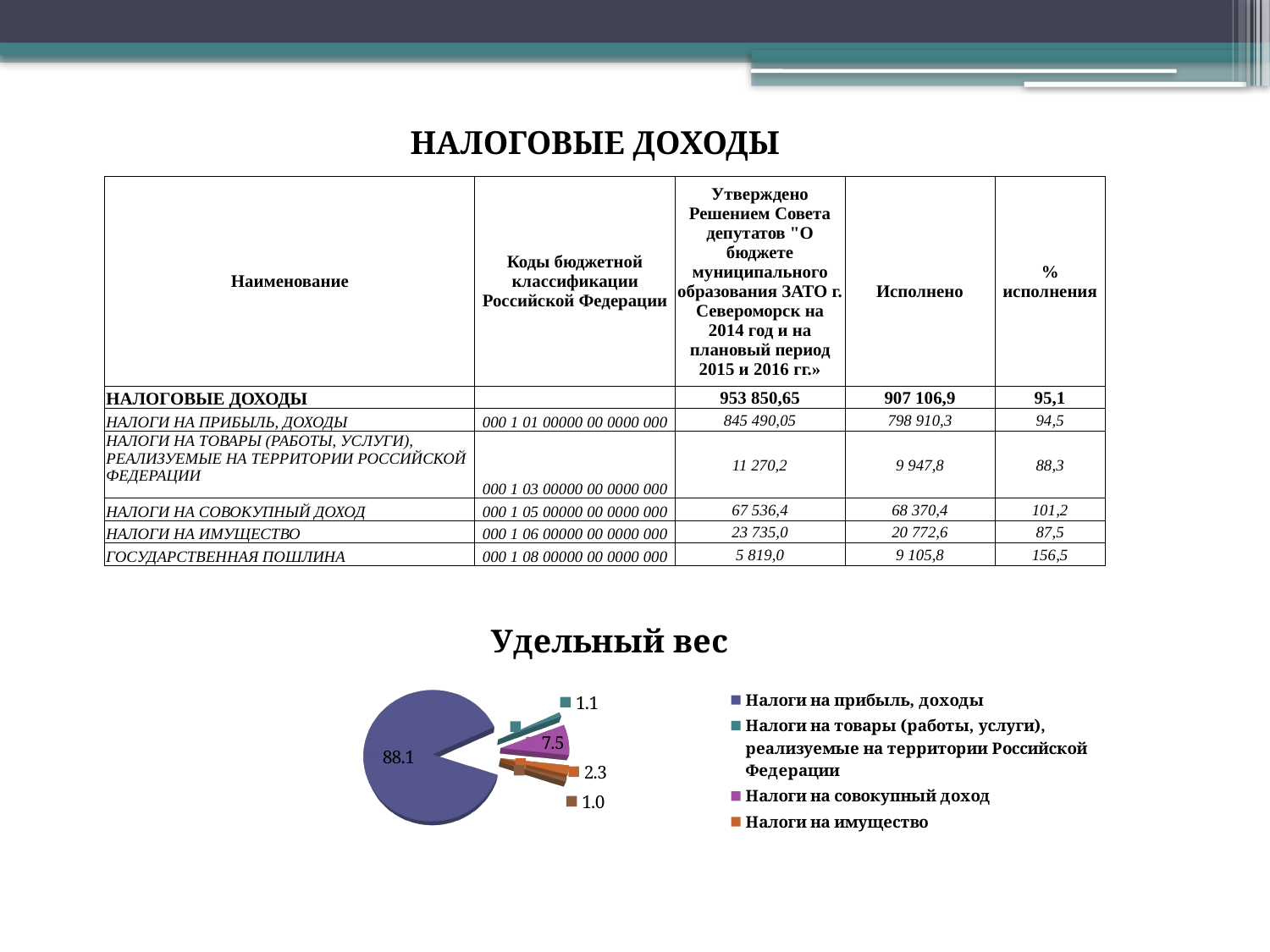
In the "Удельный вес" pie chart, which is larger: "Налоги на совокупный доход" or "Налоги на имущество"? Налоги на совокупный доход Which category has the largest slice in the "Удельный вес" pie chart? Налоги на прибыль, доходы What is the title of the pie chart on the slide? Удельный вес How many entries does the legend of the "Удельный вес" pie chart list? 4 In the "Удельный вес" pie chart, what value is shown for "Налоги на прибыль, доходы"? 88.1 In the "Удельный вес" pie chart, what is the difference between the values for "Налоги на прибыль, доходы" and "Налоги на совокупный доход"? 80.6 What type of chart is shown under the heading "Удельный вес"? Pie chart How many slices does the "Удельный вес" pie chart have? 5 In the "Удельный вес" pie chart, what value is shown for "Налоги на имущество"? 2.3 In the "Удельный вес" pie chart, what value is shown for "Налоги на товары (работы, услуги), реализуемые на территории Российской Федерации"? 1.1 What is the smallest value labeled on the "Удельный вес" pie chart? 1.0 In the "Удельный вес" pie chart, what value is shown for "Налоги на совокупный доход"? 7.5